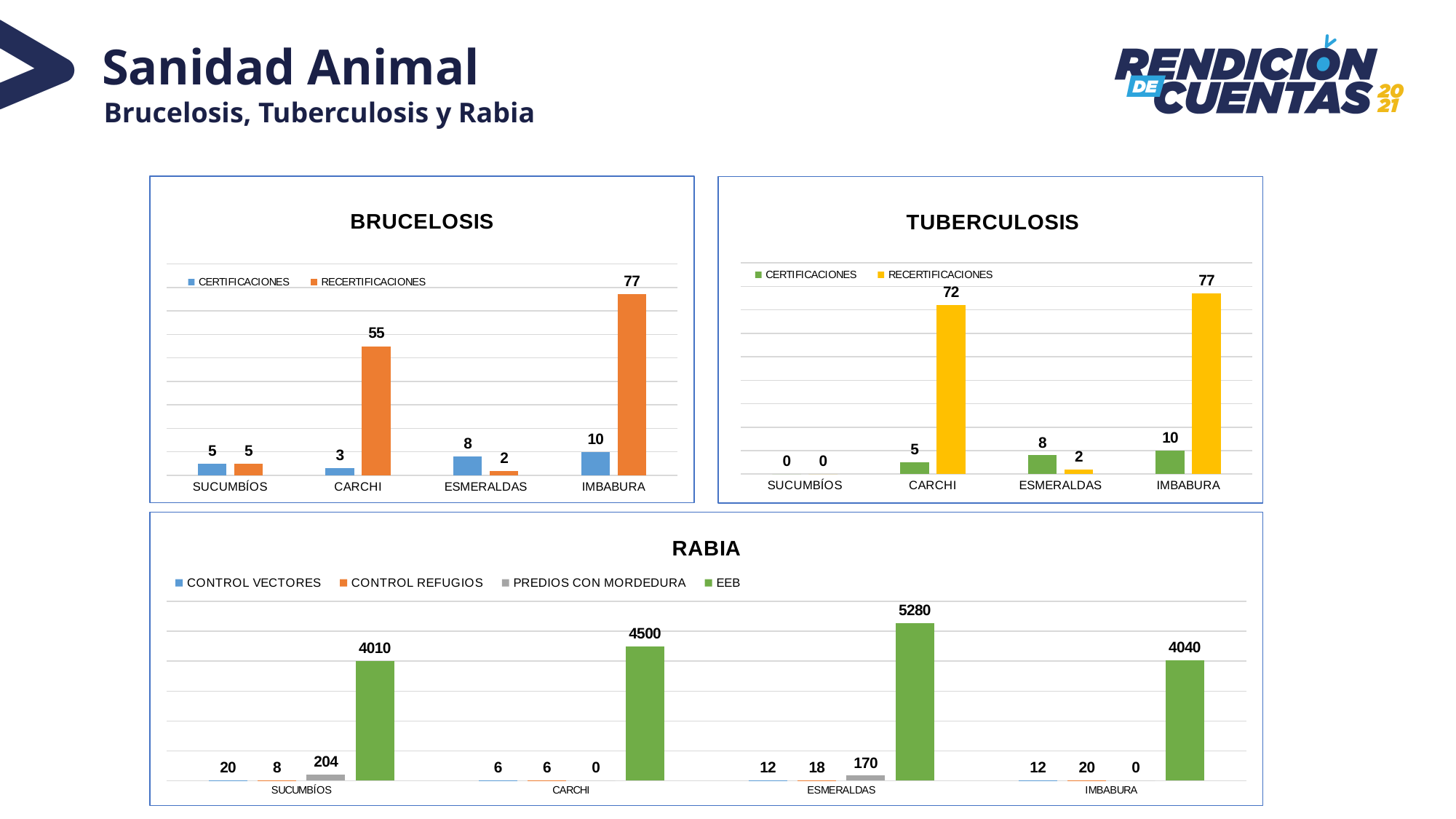
In the RABIA chart, is the EEB value for CARCHI larger or smaller than the EEB value for IMBABURA? larger In the RABIA chart, how many series does the legend list? 4 In the TUBERCULOSIS chart, what is the value of RECERTIFICACIONES for CARCHI? 72 In the RABIA chart, what is the PREDIOS CON MORDEDURA value for SUCUMBÍOS? 204 In the TUBERCULOSIS chart, how many series does the legend list? 2 In the TUBERCULOSIS chart, which category has the lowest CERTIFICACIONES value? SUCUMBÍOS In the RABIA chart, what is the EEB value for ESMERALDAS? 5280 In the BRUCELOSIS chart, which category has the highest RECERTIFICACIONES value? IMBABURA In the RABIA chart, which category has the highest EEB value? ESMERALDAS In the BRUCELOSIS chart, what is the difference between RECERTIFICACIONES and CERTIFICACIONES for IMBABURA? 67 What kind of chart is the RABIA chart? bar chart In the BRUCELOSIS chart, what is the value of RECERTIFICACIONES for CARCHI? 55